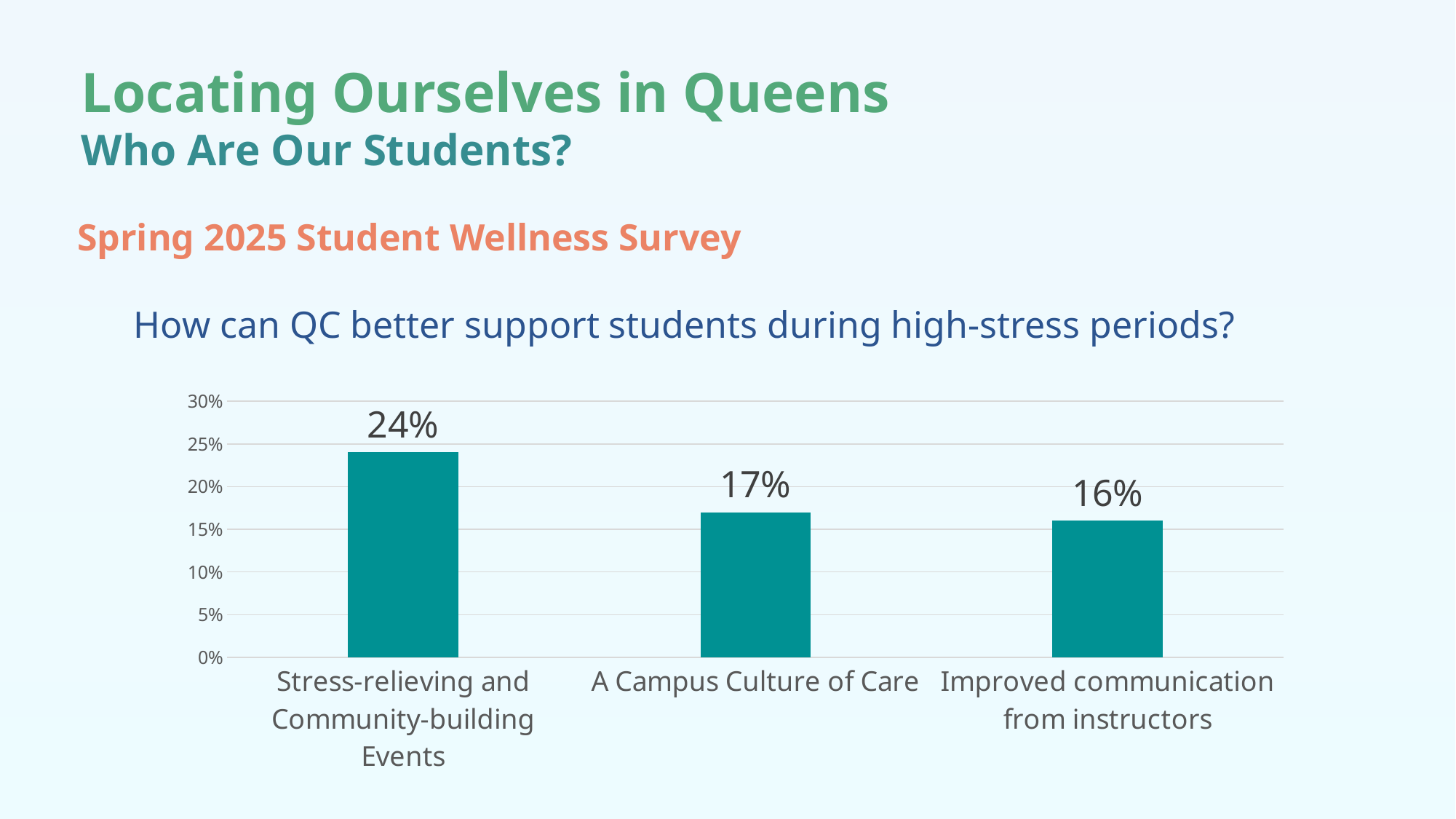
What percentage of respondents chose Stress-relieving and Community-building Events? 24% Which category has the highest value? Stress-relieving and Community-building Events What kind of chart is shown on the slide? Bar chart How many categories are shown in the chart? 3 Is the value for Stress-relieving and Community-building Events greater or less than 20%? greater What percentage of respondents chose A Campus Culture of Care? 17% Which category has the lowest value? Improved communication from instructors What is the difference between the values for Stress-relieving and Community-building Events and A Campus Culture of Care? 7% Which is larger: the value for Stress-relieving and Community-building Events or the value for Improved communication from instructors? Stress-relieving and Community-building Events What is the difference between the values for A Campus Culture of Care and Improved communication from instructors? 1% What question does the chart title ask? How can QC better support students during high-stress periods? What percentage of respondents chose Improved communication from instructors? 16%